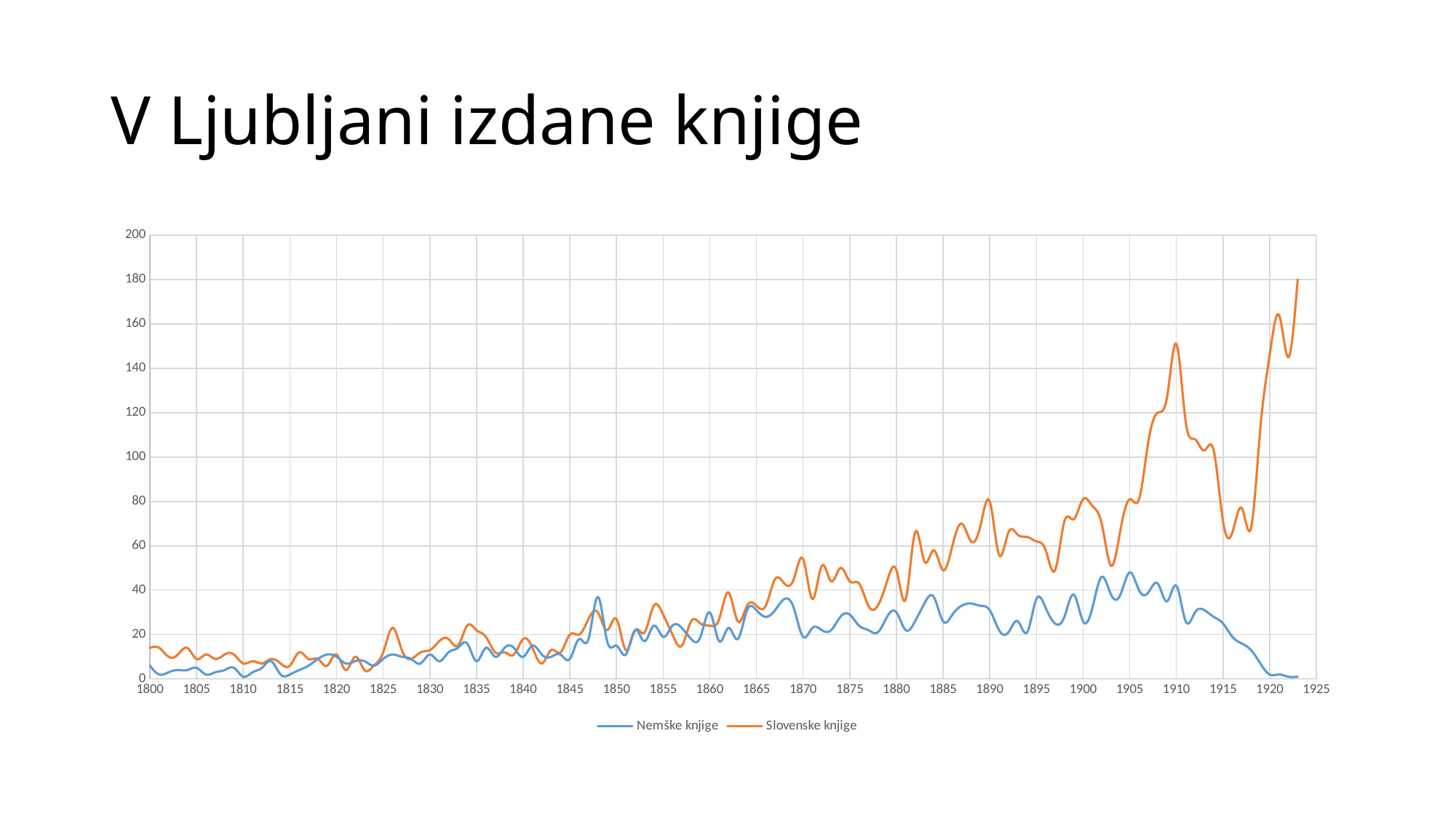
Is the value for Nemške knjige in 1920 greater or less than 20? less What are the two series named in the legend? Nemške knjige and Slovenske knjige Which series reaches the highest value on the chart? Slovenske knjige How many series does the legend list? 2 Is the value for Slovenske knjige in 1890 greater or less than 60? greater Is the value for Slovenske knjige at the end of the series (around 1923) greater or less than 160? greater What kind of chart is shown on the slide? line chart In 1900, which series has the larger value, Nemške knjige or Slovenske knjige? Slovenske knjige Does the Nemške knjige line rise or fall between 1910 and 1923? fall Overall, does the Slovenske knjige line rise or fall from 1800 to the end of the series? rise Which colour is used for the Slovenske knjige line? orange